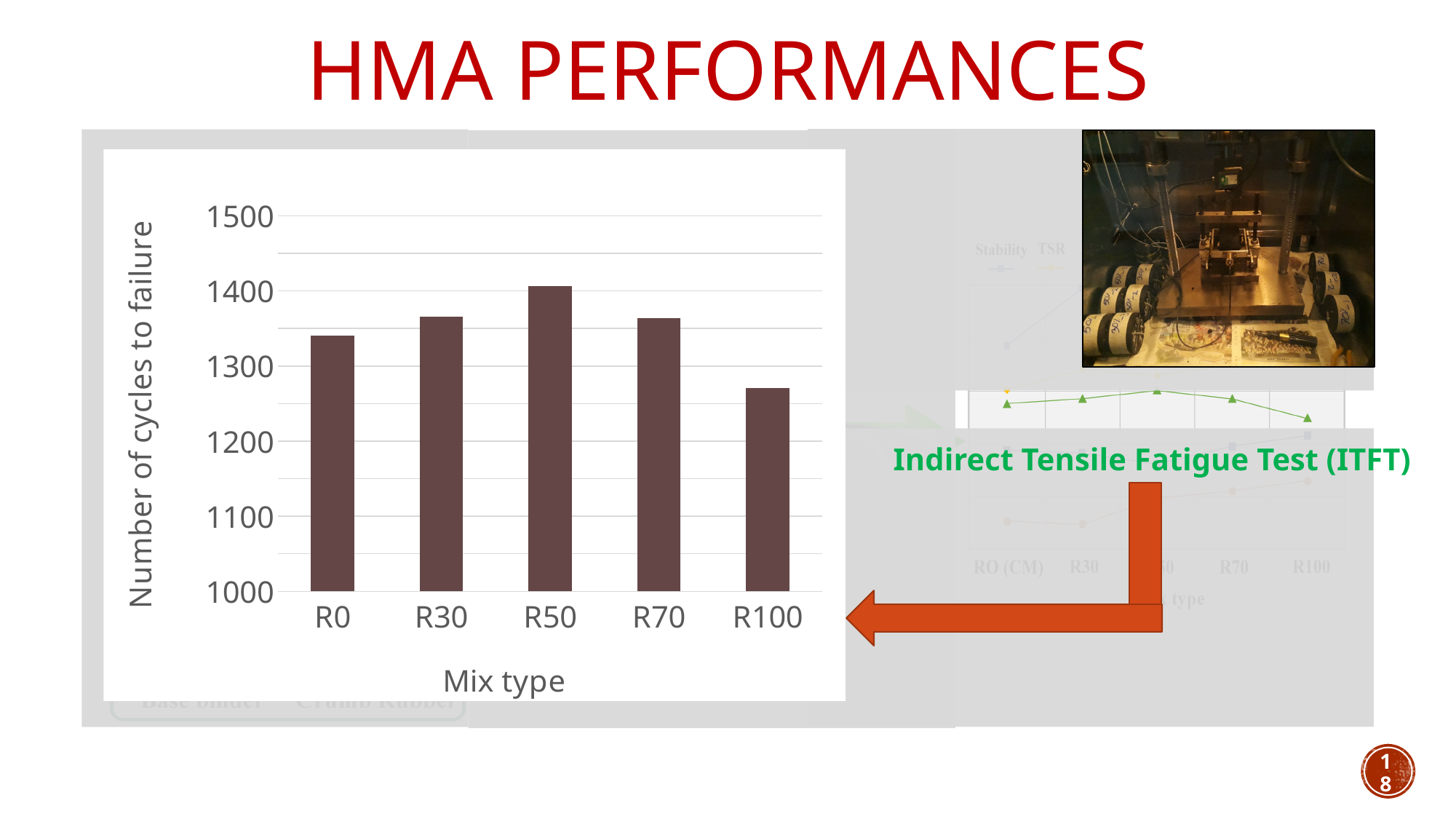
Do the values rise or fall from R50 to R100 along the x axis? fall Which mix type has the lowest number of cycles to failure? R100 Which has a higher number of cycles to failure, R0 or R50? R50 How many mix types are shown on the x axis of the chart? 5 Is the value for R100 greater or less than 1200? greater What kind of chart is shown on the slide? bar chart Is the value for R100 greater or less than 1300? less Which mix type has the highest number of cycles to failure? R50 Is the value for R0 greater or less than 1300? greater Which has a higher number of cycles to failure, R50 or R100? R50 What is the label of the y axis of the chart? Number of cycles to failure